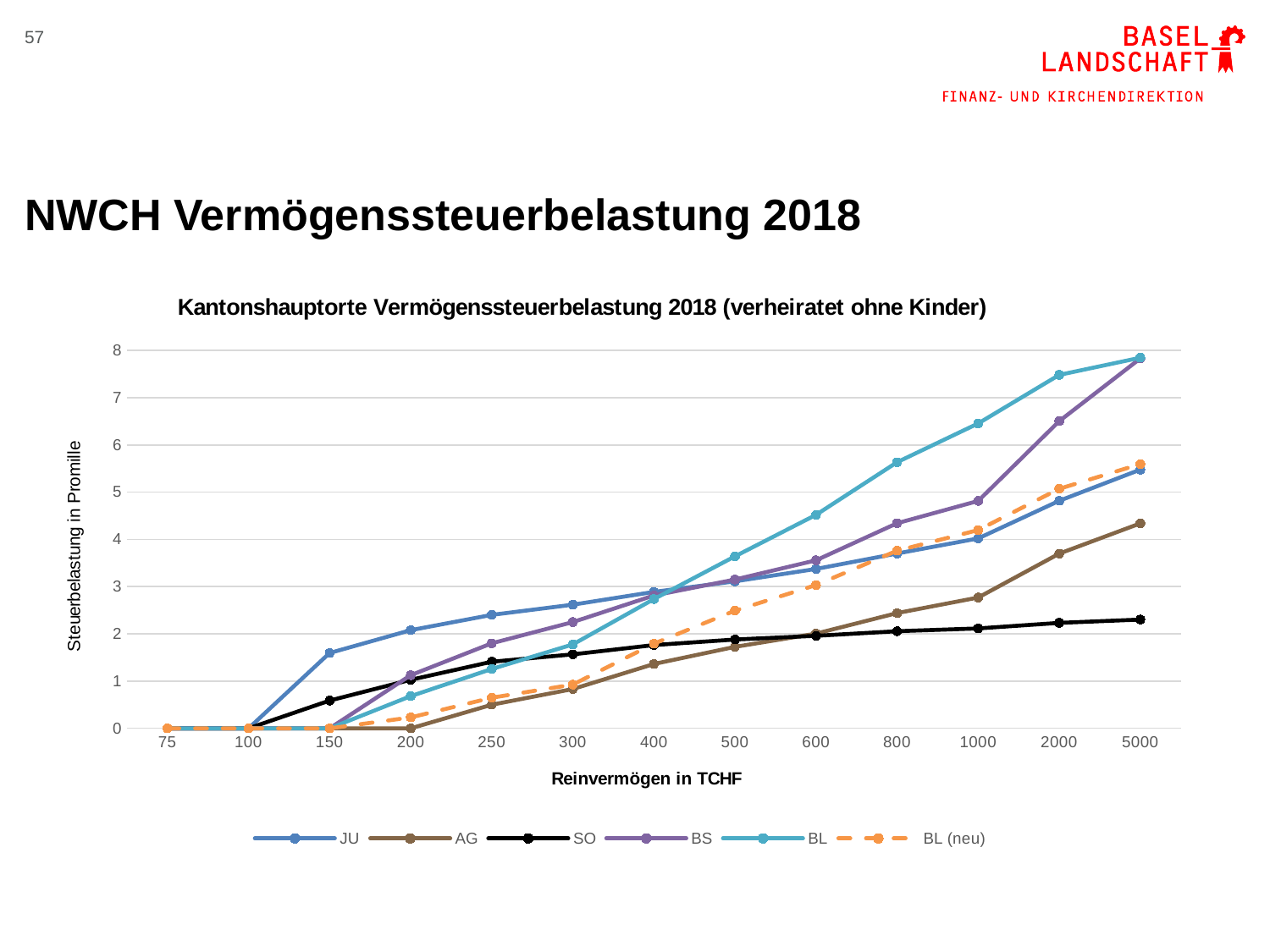
Is the value for BL at 5000 TCHF greater or less than 7? greater What is the label of the y axis? Steuerbelastung in Promille Which series has the highest Steuerbelastung at 200 TCHF? JU What kind of chart is shown on the slide? line chart Does the SO series rise or fall as Reinvermögen increases along the x axis? rise Is the value for SO at 5000 TCHF greater or less than 3? less How many series does the legend list? 6 Is the value for AG at 5000 TCHF greater or less than 4? greater At 5000 TCHF, which is larger: the value for AG or the value for SO? AG Which series has the highest Steuerbelastung at 1000 TCHF? BL Which series has the lowest Steuerbelastung at 5000 TCHF? SO How many values of Reinvermögen are shown on the x axis? 13